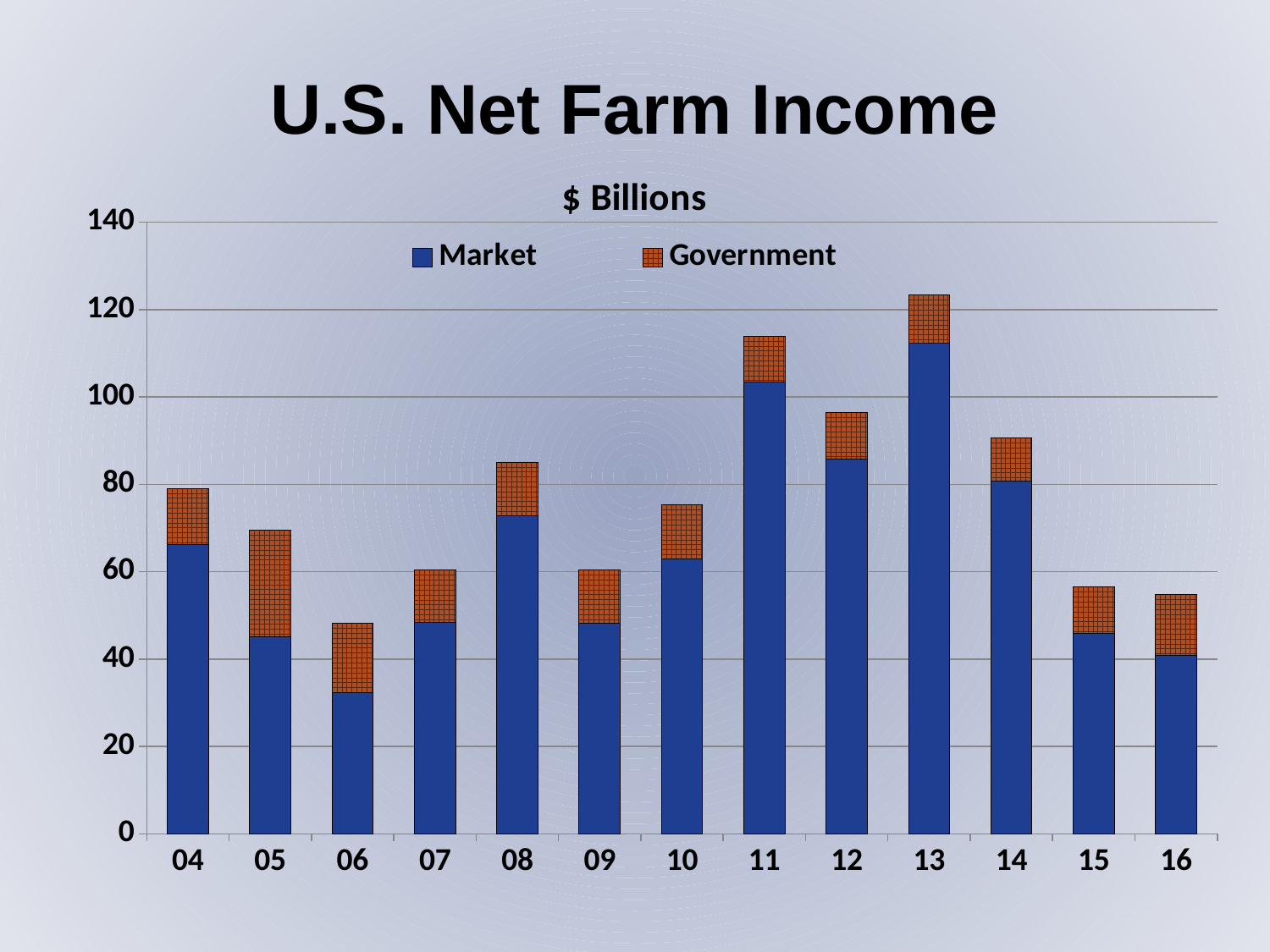
What kind of chart is shown on the slide? stacked bar chart Is the total value for 11 greater or less than 100? greater Is the total value for 06 greater or less than 60? less Do the total values rise or fall from 13 to 16? fall Is the Market value for 13 greater or less than 100? greater What unit is given for the values in the chart? $ Billions Which year has the lowest total net farm income? 06 Which year has the highest total net farm income? 13 Which year has the lowest Market value? 06 How many series does the legend list? 2 Which year has the larger total, 11 or 12? 11 How many years are shown on the x axis? 13